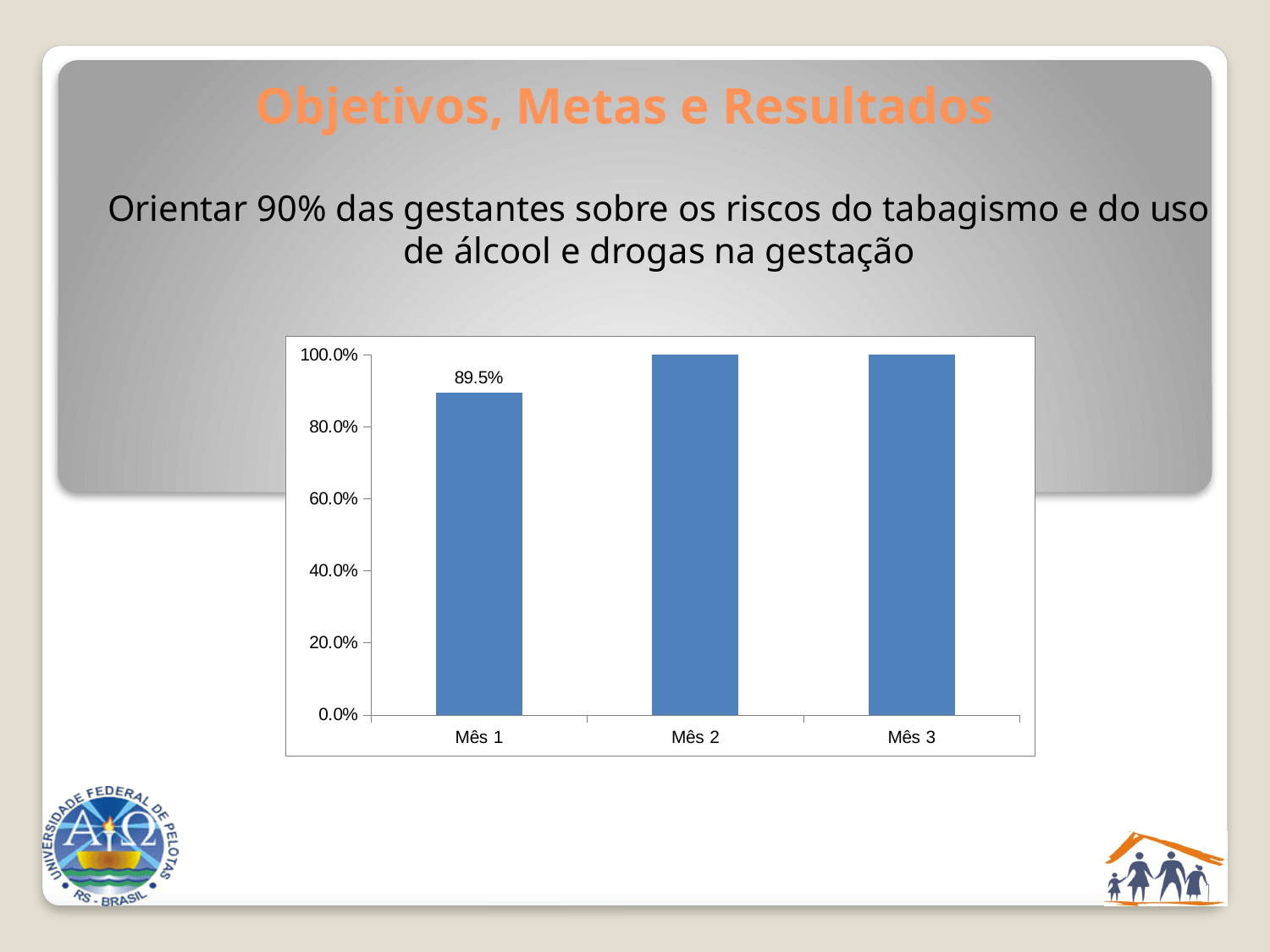
What kind of chart is shown on the slide? bar chart Which is larger, the value for Mês 1 or the value for Mês 2? Mês 2 Do the values rise or fall from Mês 1 to Mês 2? rise How many months are shown on the x axis? 3 Is the value for Mês 3 greater or less than 80.0%? greater What is the value for Mês 1? 89.5% Is the value for Mês 1 greater or less than 100.0%? less What colour are the bars in the chart? blue Which month has the lowest value? Mês 1 What is the highest value shown on the y axis? 100.0% Is the value for Mês 1 greater or less than 80.0%? greater